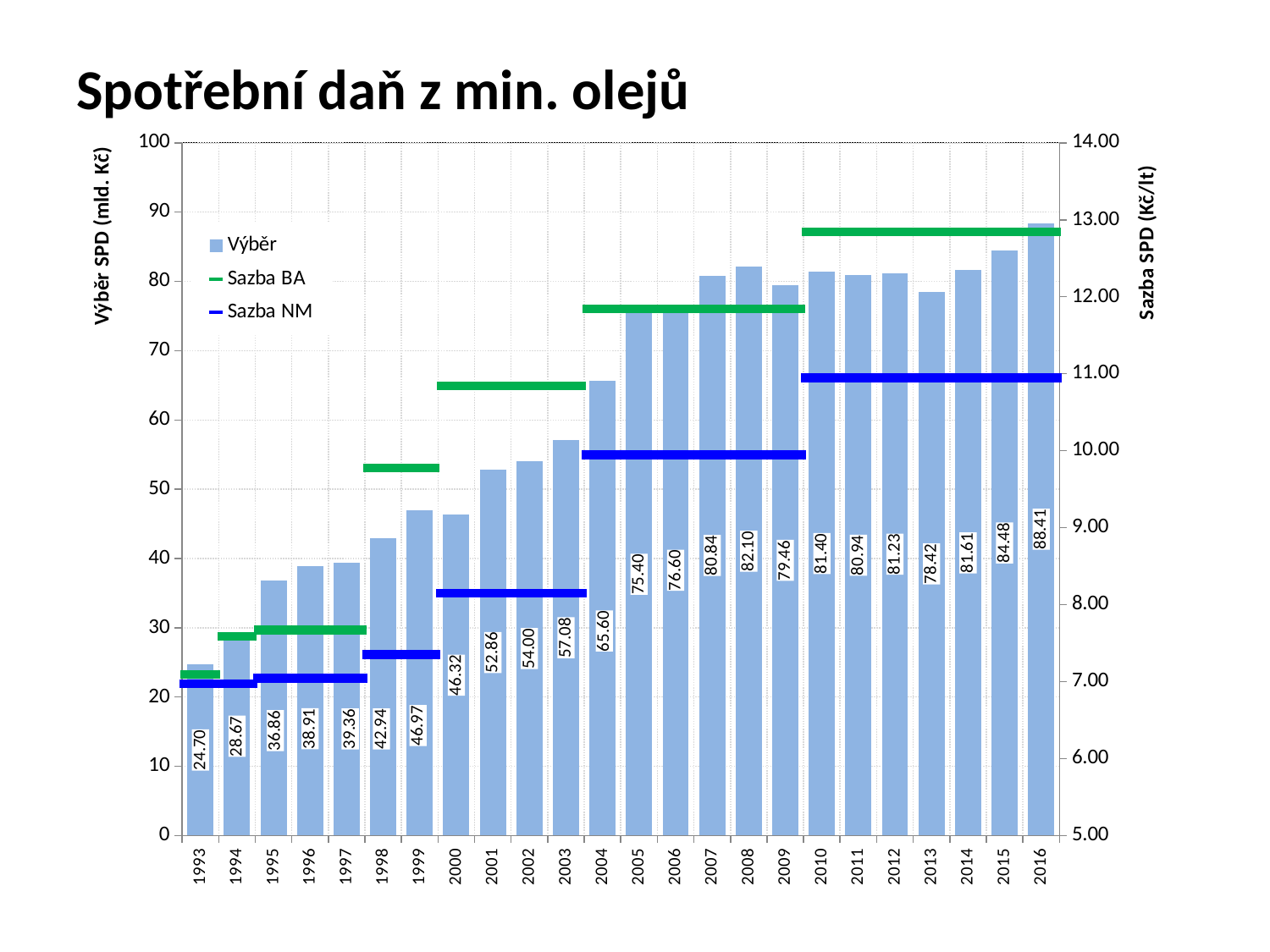
What is the label of the right-hand vertical axis? Sazba SPD (Kč/lt) Which year has the lowest Výběr value? 1993 Which year has the highest Výběr value? 2016 What is the difference between the Výběr values for 2016 and 1993? 63.71 How many series does the legend list? 3 What is the Výběr value for 2004? 65.60 What is the Výběr value for 2016? 88.41 What is the difference between the Výběr values for 2008 and 2009? 2.64 Which year has the larger Výběr value, 2004 or 2005? 2005 Is the Sazba NM value for 2000 greater or less than 9.00 on the right axis? less Is the Sazba BA value for 2016 greater or less than 12.00 on the right axis? greater How many years are shown on the x axis? 24